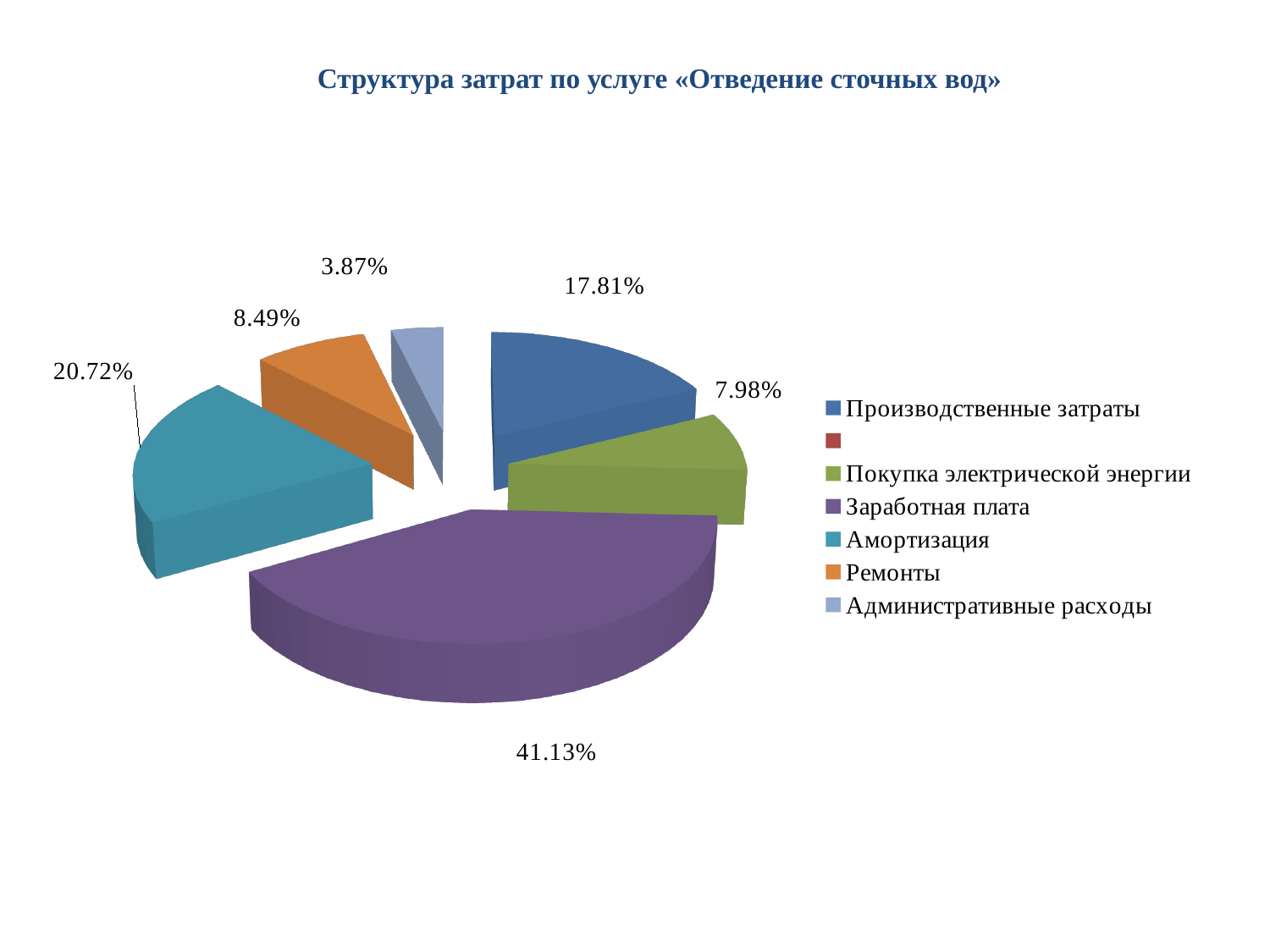
By how many percentage points does Заработная плата exceed Амортизация? 20.41 What is the value for Ремонты? 8.49% Which category has the largest share of the pie? Заработная плата What type of chart is shown on the slide? Pie chart What is the value shown for Амортизация? 20.72% What share is shown for Административные расходы? 3.87% Which is larger, the share for Ремонты or for Покупка электрической энергии? Ремонты What percentage is shown for Производственные затраты? 17.81% What share of costs does Заработная плата account for? 41.13% Which category has the smallest share of the pie? Административные расходы What is the value for Покупка электрической энергии? 7.98% How many slices does the pie chart have? 6